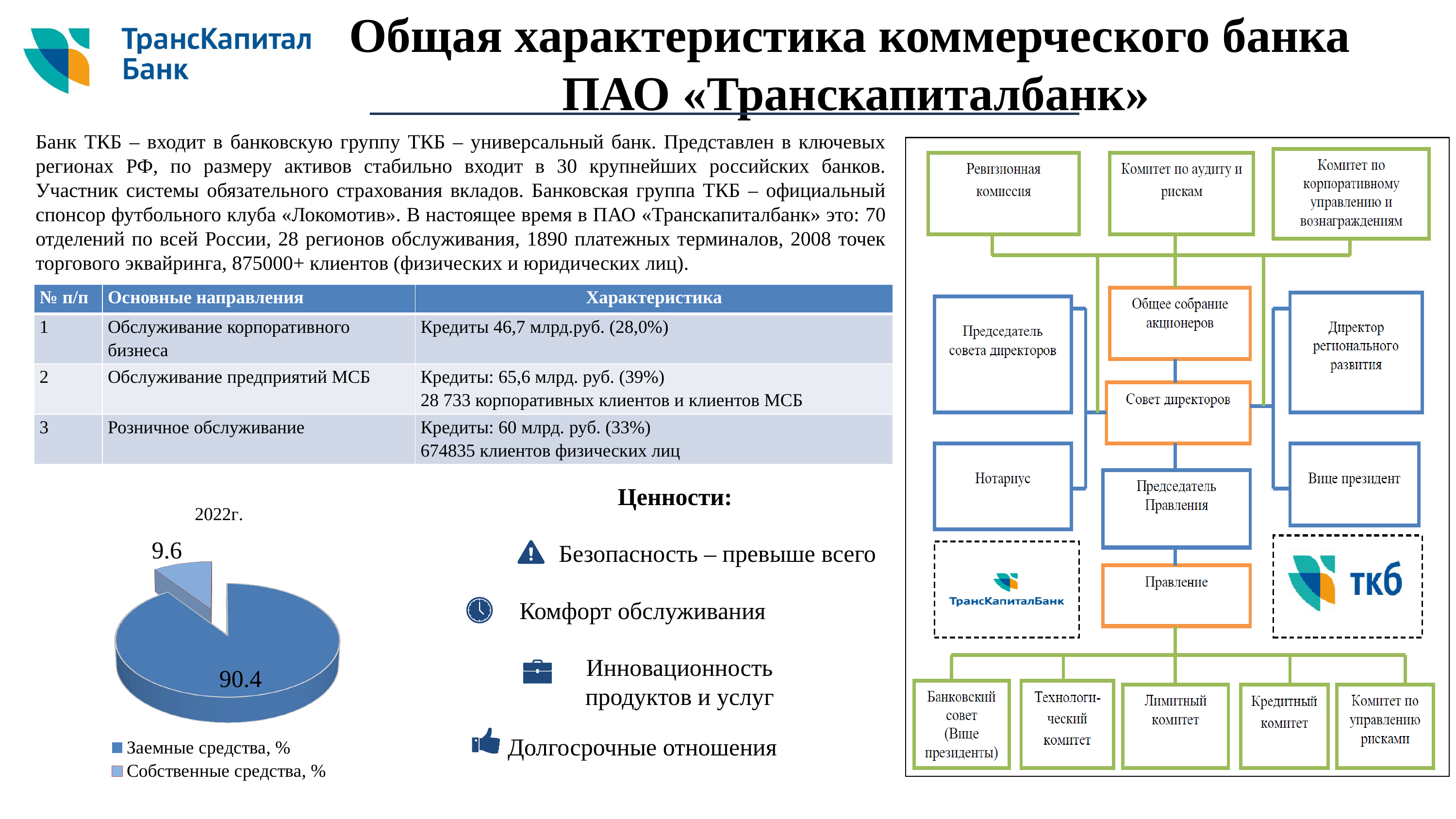
What is the difference between the values for Заемные средства, % and Собственные средства, % in the pie chart? 80.8 Which slice of the pie chart is the largest? Заемные средства, % What is the value for Собственные средства, % in the pie chart? 9.6 What is the title of the pie chart? 2022г. How many entries does the legend of the pie chart list? 2 Which is larger in the pie chart: Заемные средства, % or Собственные средства, %? Заемные средства, % Which legend entry in the pie chart is shown in the lighter blue colour? Собственные средства, % What is the total of the two values shown in the pie chart? 100 Which slice of the pie chart is the smallest? Собственные средства, % How many slices does the pie chart have? 2 What is the value for Заемные средства, % in the pie chart? 90.4 What kind of chart is shown on the slide? pie chart